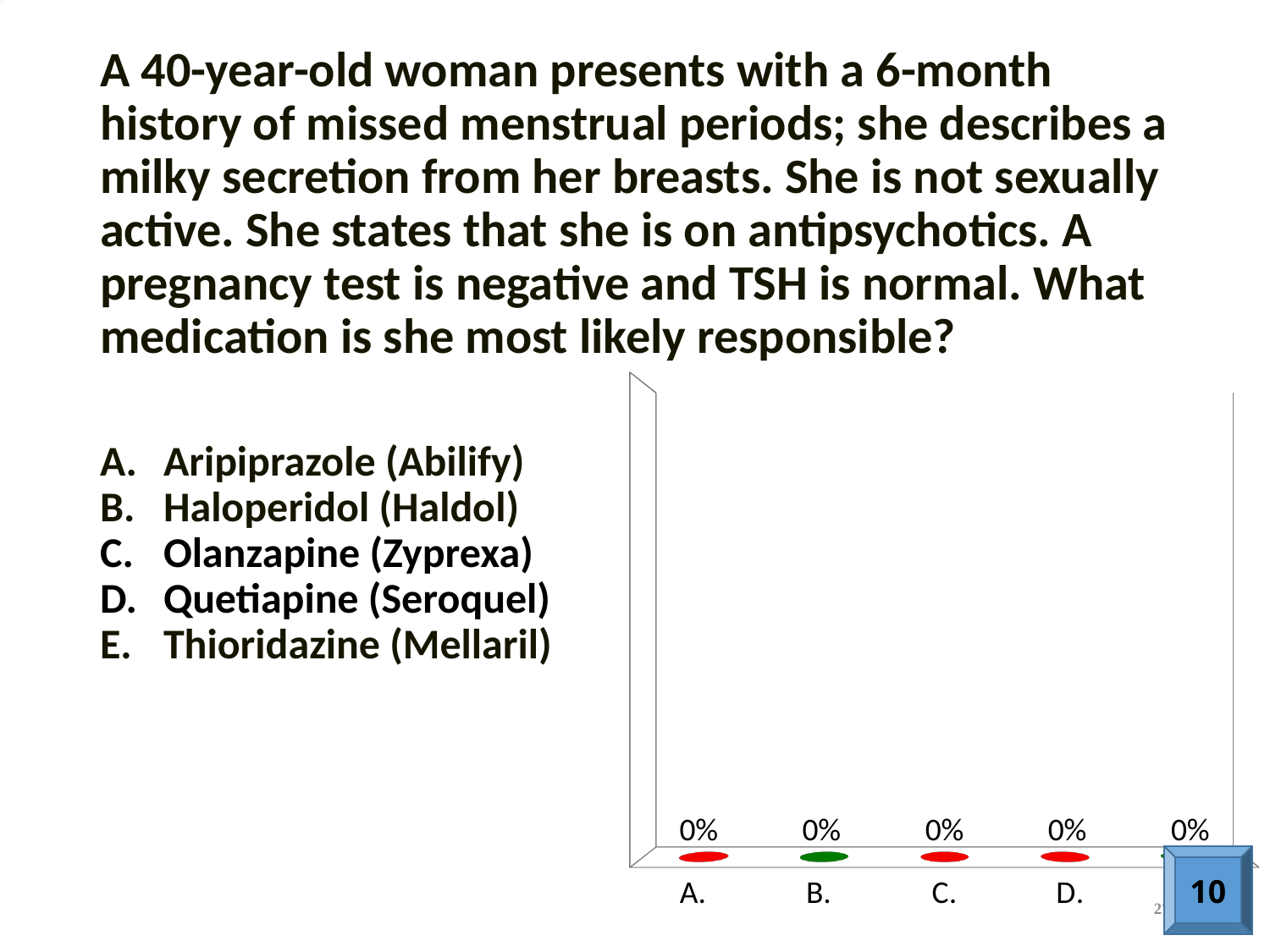
What is the value shown for category C.? 0% What is the value shown for category D.? 0% What is the difference between the values for category C. and category D.? 0% What is the value shown for category A.? 0% How many data labels are shown on the chart? 5 What is the value shown for category B.? 0% What colour is the bar for category B.? green What type of chart is shown on the slide? bar chart What colour is the bar for category A.? red What is the difference between the values for category A. and category B.? 0%